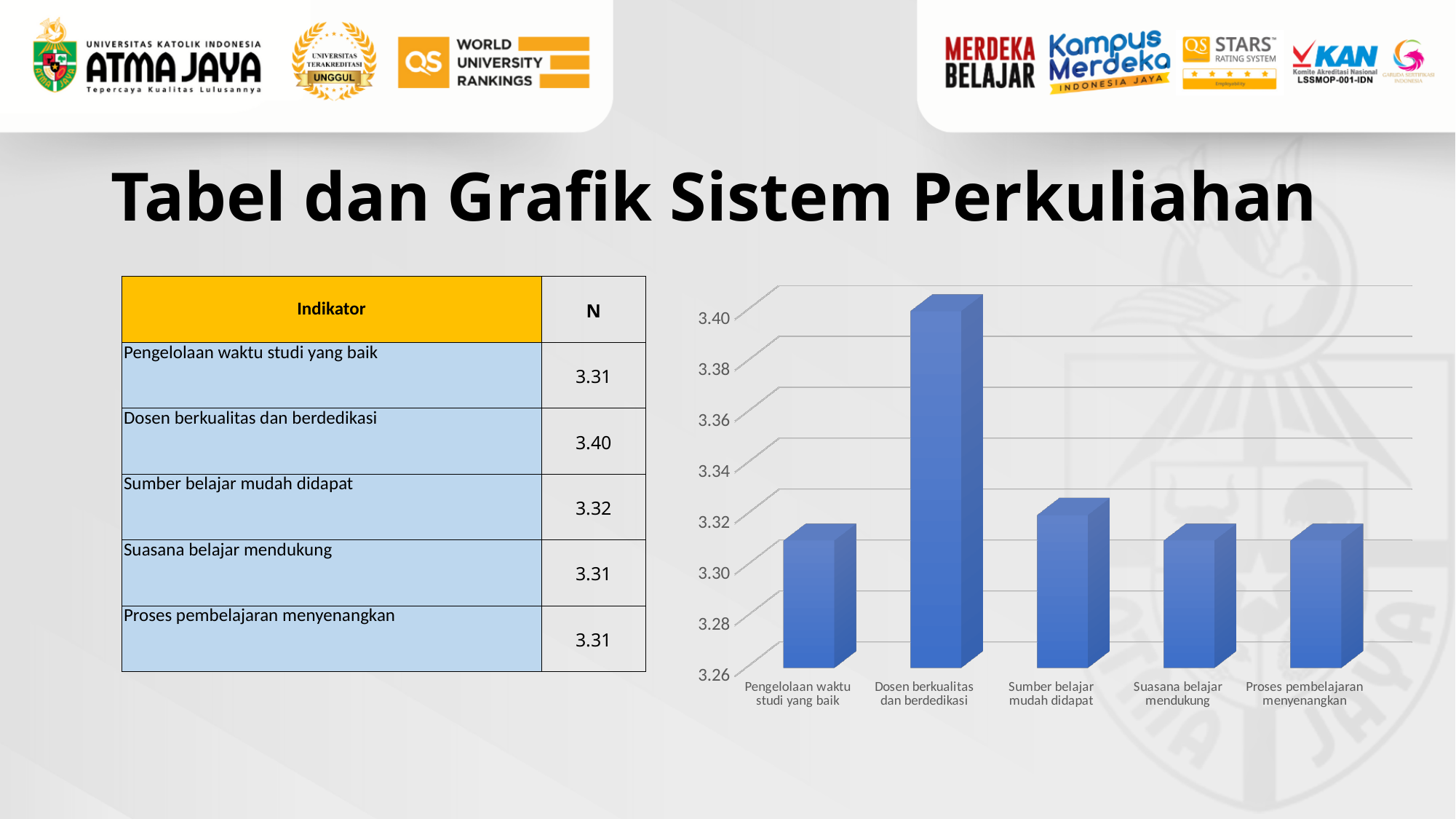
What is the value for Proses pembelajaran menyenangkan? 3.31 What is the value for Sumber belajar mudah didapat? 3.32 Is the value for Dosen berkualitas dan berdedikasi greater or less than 3.38? greater What is the value for Dosen berkualitas dan berdedikasi? 3.40 Is the value for Pengelolaan waktu studi yang baik greater or less than 3.34? less Which category has the highest value in the chart? Dosen berkualitas dan berdedikasi Which is larger, the value for Dosen berkualitas dan berdedikasi or the value for Suasana belajar mendukung? Dosen berkualitas dan berdedikasi What is the difference between the values for Dosen berkualitas dan berdedikasi and Sumber belajar mudah didapat? 0.08 What is the value for Pengelolaan waktu studi yang baik? 3.31 What kind of chart is shown on the slide? bar chart What is the difference between the values for Dosen berkualitas dan berdedikasi and Suasana belajar mendukung? 0.09 How many categories are plotted in the bar chart? 5